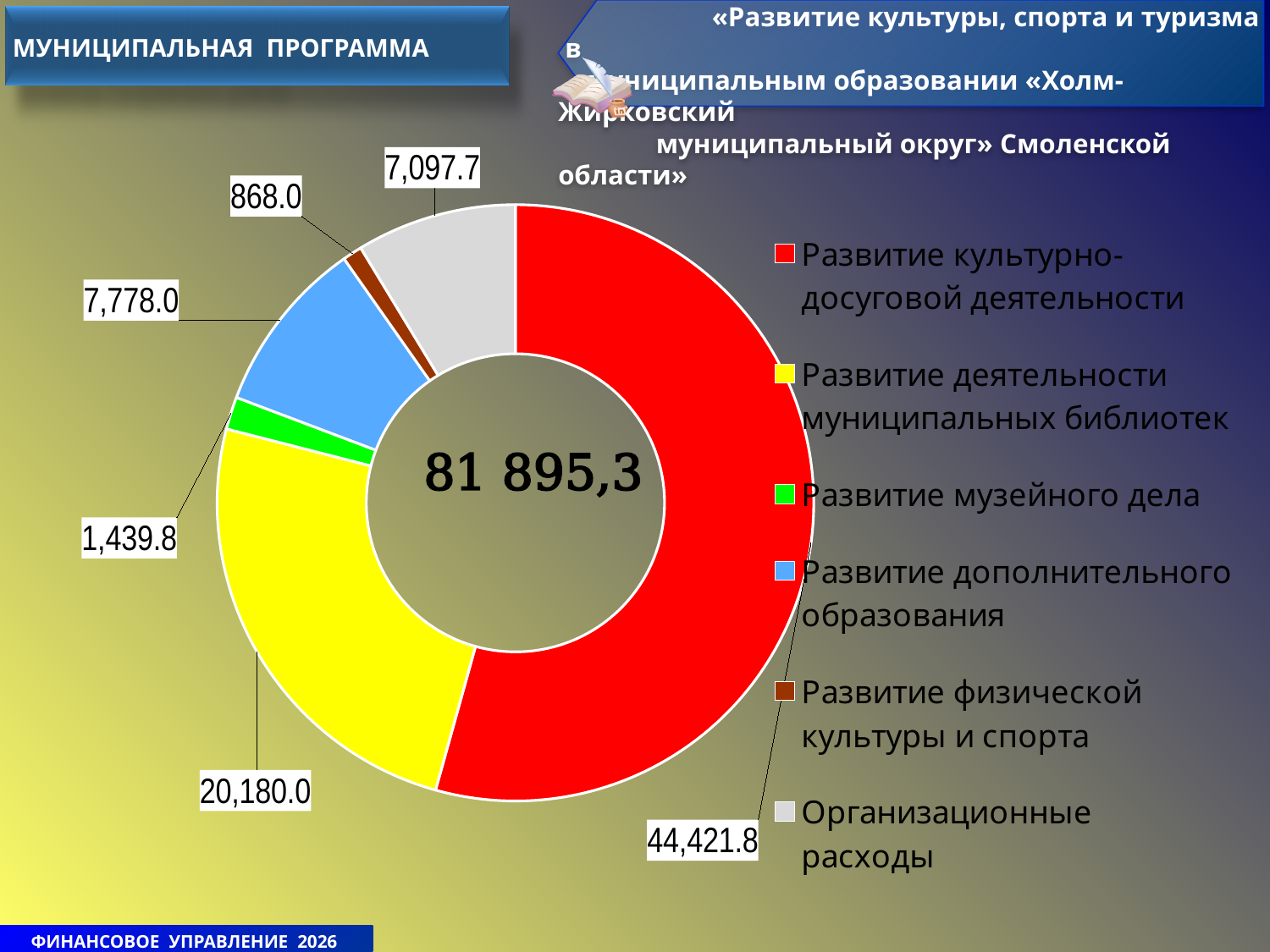
What is the value for «Развитие музейного дела»? 1,439.8 What is the value for «Организационные расходы»? 7,097.7 Which is larger: «Развитие дополнительного образования» or «Организационные расходы»? Развитие дополнительного образования What is the value for «Развитие деятельности муниципальных библиотек»? 20,180.0 What kind of chart is shown on the slide? Doughnut (pie) chart What is the difference between «Развитие деятельности муниципальных библиотек» and «Развитие дополнительного образования»? 12,402.0 What is the value for «Развитие физической культуры и спорта»? 868.0 Which category has the smallest slice? Развитие физической культуры и спорта What is the value for «Развитие культурно-досуговой деятельности»? 44,421.8 Which category has the largest slice? Развитие культурно-досуговой деятельности How many categories does the chart show? 6 What number is printed in the centre of the doughnut chart? 81 895,3